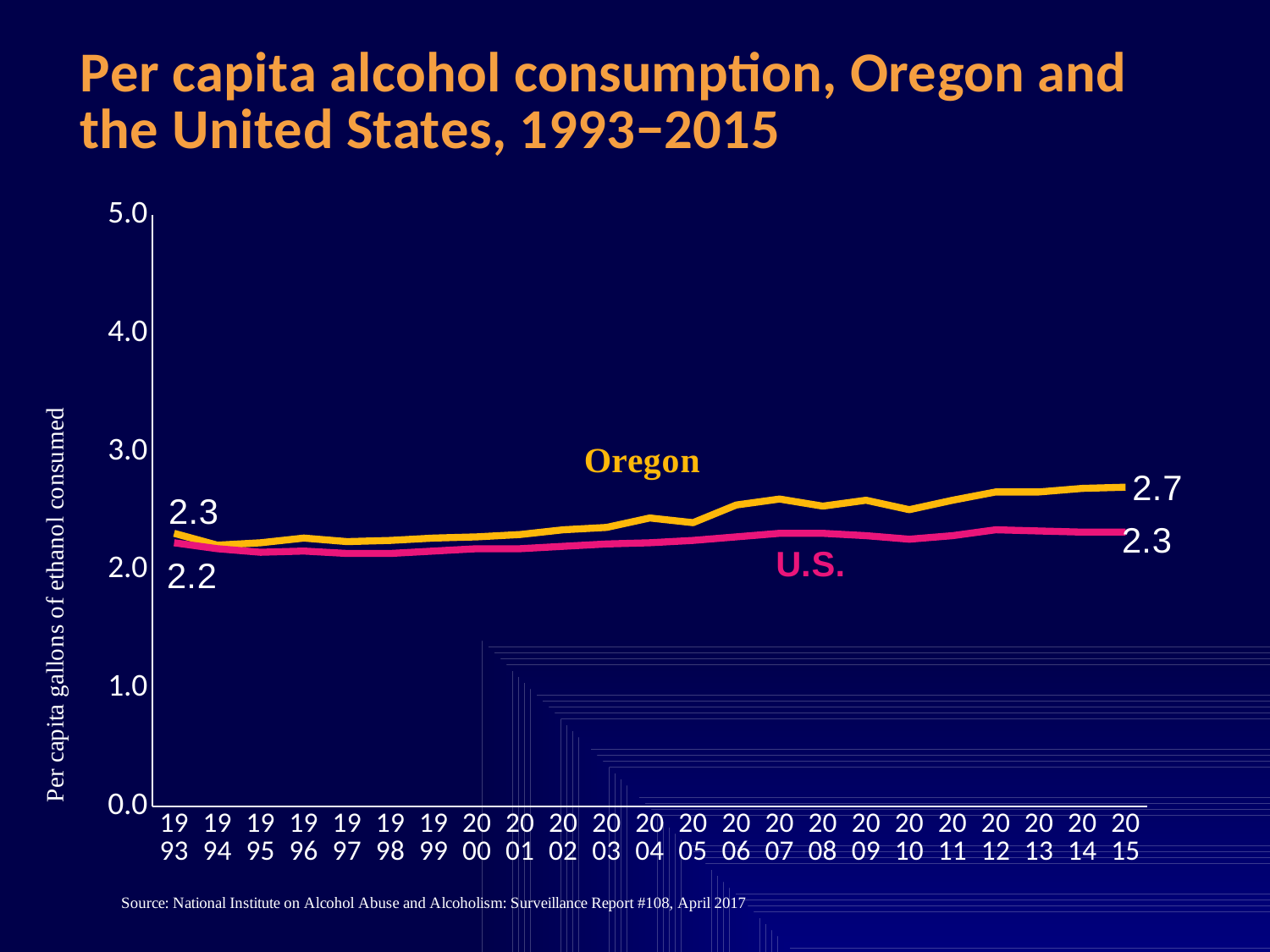
How many years are shown on the x axis of the chart? 23 In 2015, which has the higher per capita alcohol consumption, Oregon or the U.S.? Oregon Is the U.S. per capita alcohol consumption in 2015 greater or less than 2.0? greater What is the per capita alcohol consumption for the U.S. in 2015? 2.3 What is the per capita alcohol consumption for the U.S. in 1993? 2.2 What is the difference between Oregon's and the U.S. per capita alcohol consumption in 2015? 0.4 Is Oregon's per capita alcohol consumption in 2015 greater or less than 3.0? less What kind of chart is shown on the slide? Line chart What is the per capita alcohol consumption for Oregon in 2015? 2.7 Does Oregon's per capita alcohol consumption generally rise or fall from 1993 to 2015? Rise What is the per capita alcohol consumption for Oregon in 1993? 2.3 By how much did Oregon's per capita alcohol consumption change from 1993 to 2015? 0.4